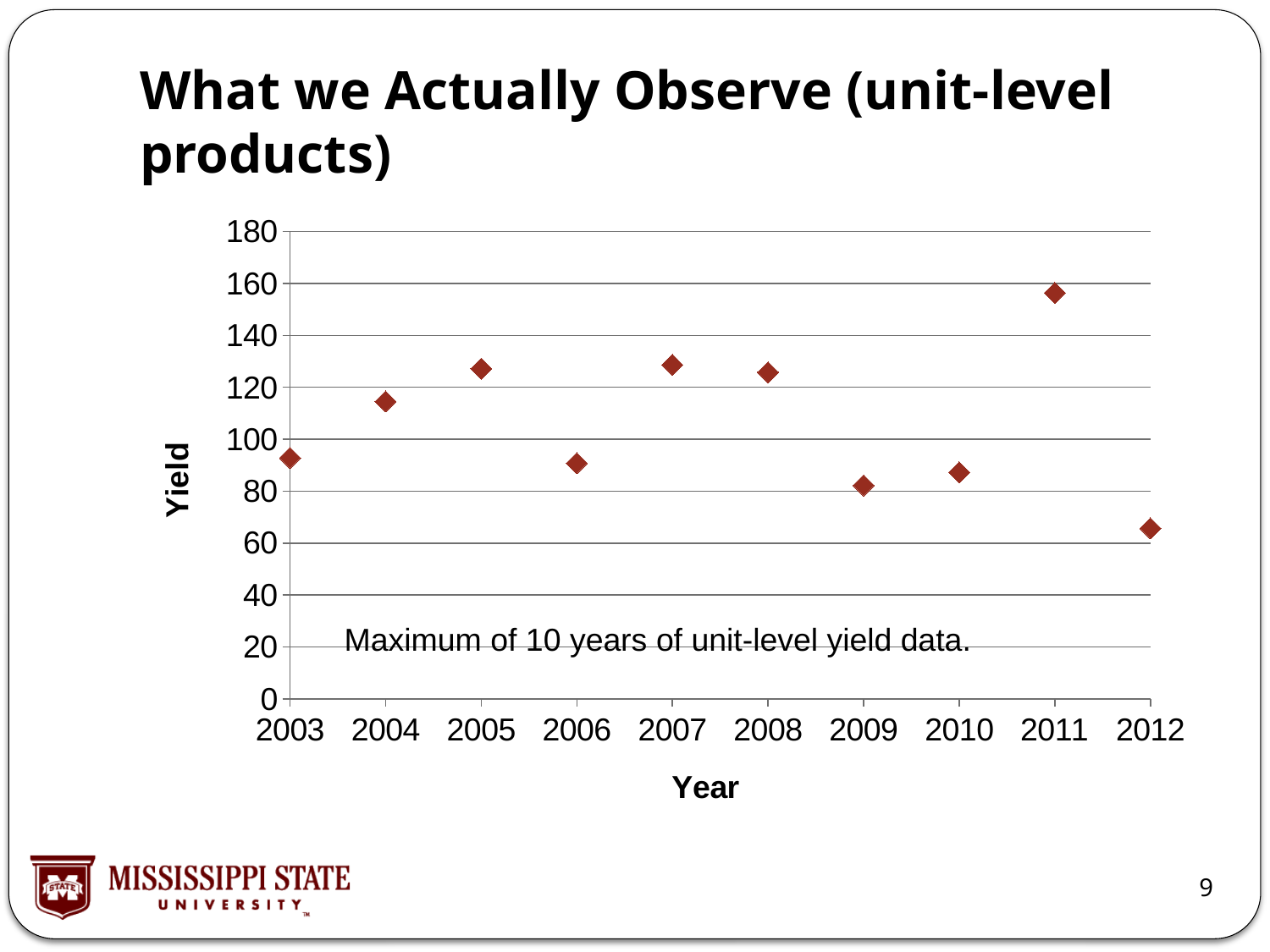
Which year has the larger yield, 2004 or 2009? 2004 What is the title of the vertical axis? Yield What kind of chart is shown on the slide? scatter chart Is the yield for 2008 greater or less than 100? greater Which year has the lowest yield? 2012 Which year has the highest yield? 2011 How many data points are plotted on the chart? 10 Is the yield for 2012 greater or less than 80? less Is the yield for 2003 greater or less than 100? less Does the yield rise or fall from 2011 to 2012? fall